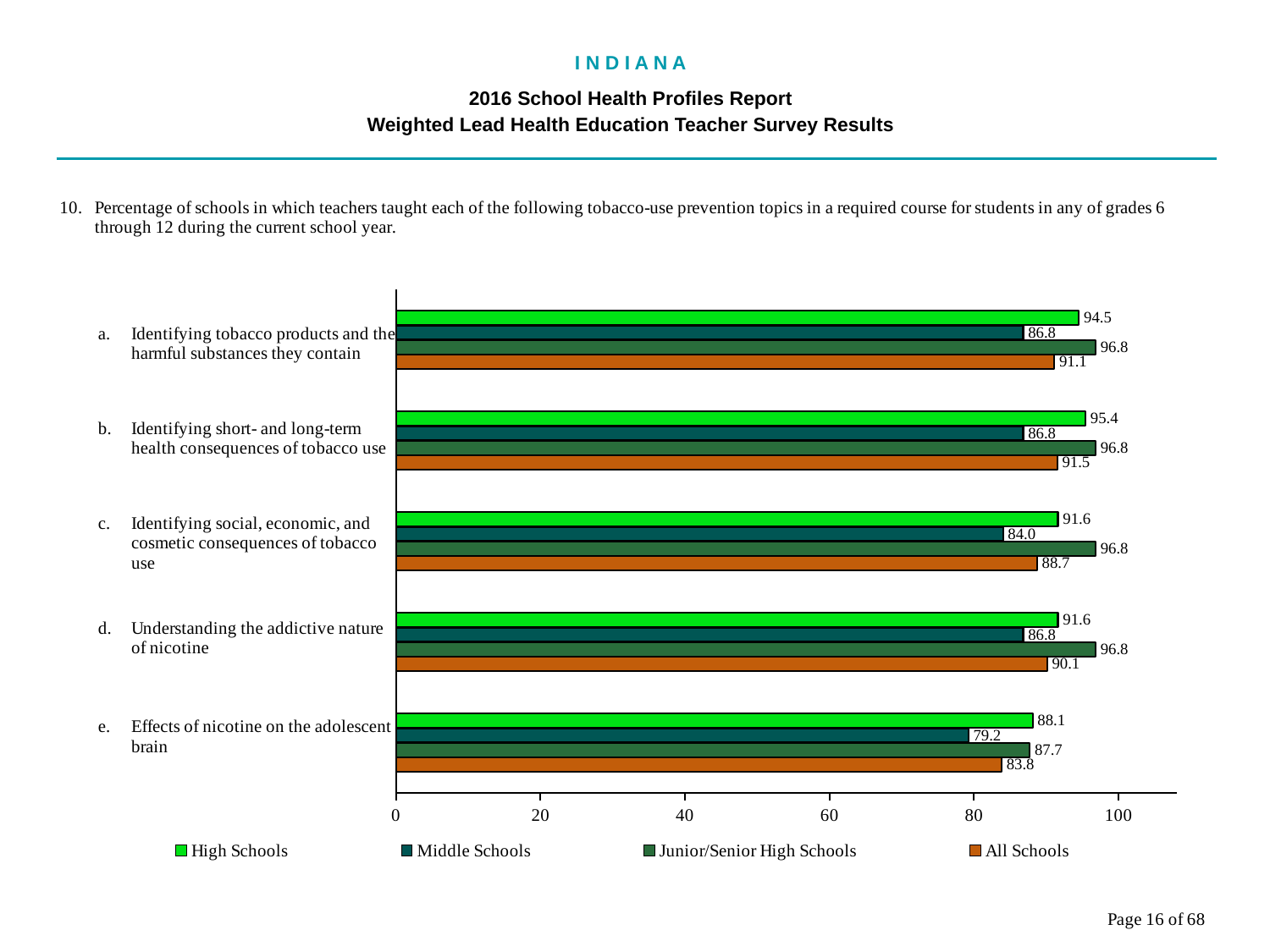
Is the Middle Schools value for topic e greater or less than 80? less What is the value for All Schools for topic c, identifying social, economic, and cosmetic consequences of tobacco use? 88.7 Which legend entry is shown in orange? All Schools Which topic has the highest value for High Schools? b. Identifying short- and long-term health consequences of tobacco use How many tobacco-use prevention topics are shown on the chart? 5 What is the value for Middle Schools for topic e, effects of nicotine on the adolescent brain? 79.2 Which topic has the lowest value for Junior/Senior High Schools? e. Effects of nicotine on the adolescent brain What is the difference between the High Schools and Middle Schools values for topic b? 8.6 What is the value for High Schools for topic a, identifying tobacco products and the harmful substances they contain? 94.5 How many series does the legend list? 4 For topic d, understanding the addictive nature of nicotine, which is larger: the High Schools value or the All Schools value? High Schools What kind of chart is shown on the slide? bar chart